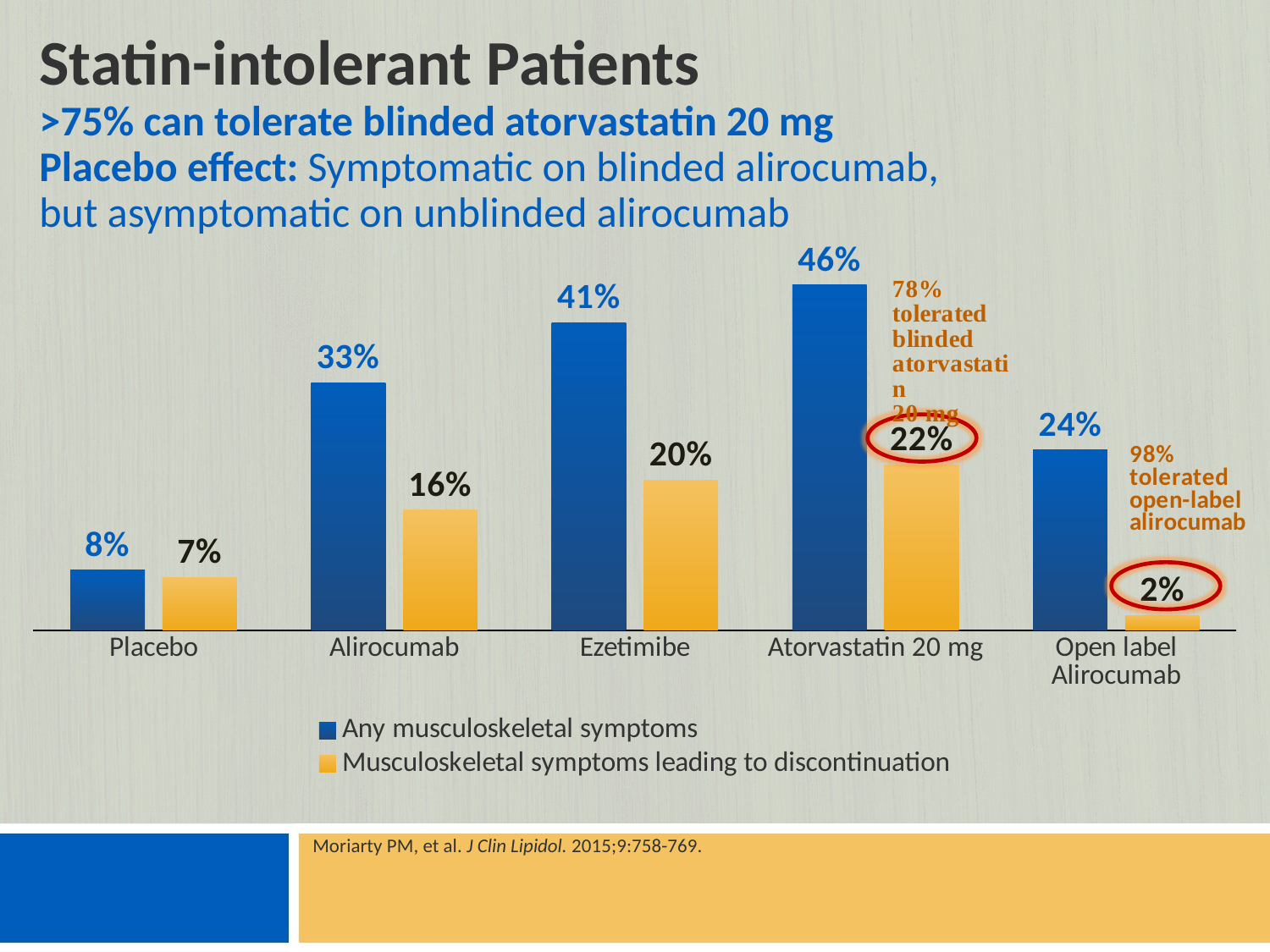
Which group has the highest value for 'Any musculoskeletal symptoms'? Atorvastatin 20 mg How many treatment groups are shown on the x axis? 5 What kind of chart is shown on the slide? Bar chart How many series does the legend list? 2 Which group has the lowest value for 'Musculoskeletal symptoms leading to discontinuation'? Open label Alirocumab What is the value for 'Any musculoskeletal symptoms' in the Atorvastatin 20 mg group? 46% What is the difference between 'Any musculoskeletal symptoms' and 'Musculoskeletal symptoms leading to discontinuation' in the Ezetimibe group? 21% What is the value for 'Musculoskeletal symptoms leading to discontinuation' in the Alirocumab group? 16% Which colour represents 'Musculoskeletal symptoms leading to discontinuation' in the legend? Orange What is the value for 'Any musculoskeletal symptoms' in the Placebo group? 8% What is the value for 'Musculoskeletal symptoms leading to discontinuation' in the Open label Alirocumab group? 2% Which is larger: 'Any musculoskeletal symptoms' for Alirocumab or for Ezetimibe? Ezetimibe